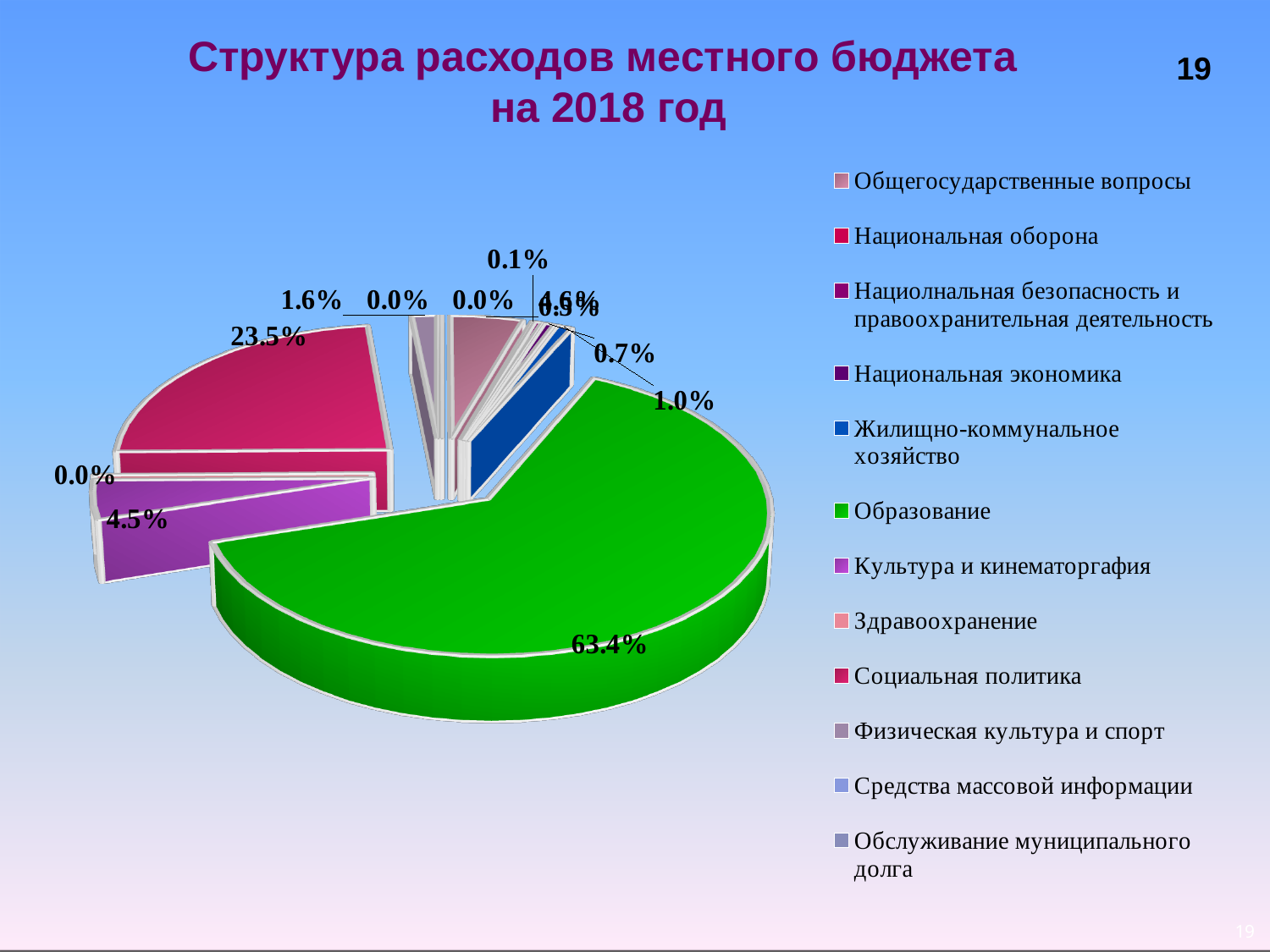
What is the difference in percentage points between the Образование slice and the Социальная политика slice? 39.9 How many categories does the legend list? 12 What share of the pie does Социальная политика have? 23.5% What kind of chart is shown on the slide? pie chart What share of the pie does Образование have? 63.4% Which is larger, the slice for Образование or the slice for Социальная политика? Образование What colour is the Образование slice? green Which is larger, the slice for Социальная политика or the slice for Культура и кинематоргафия? Социальная политика What is the title of the chart on the slide? Структура расходов местного бюджета на 2018 год Which category has the largest slice of the pie? Образование What share of the pie does Культура и кинематоргафия have? 4.5%